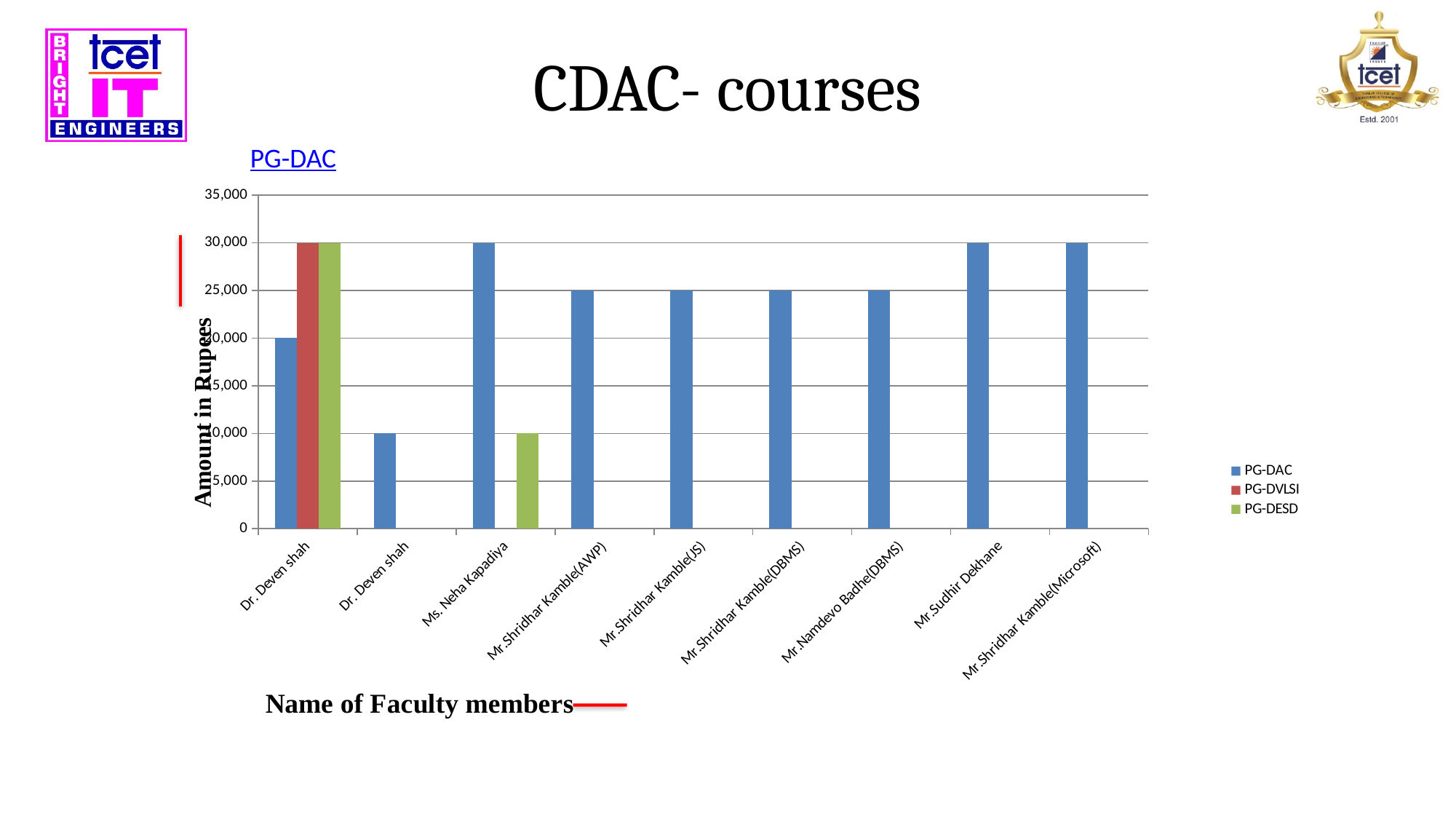
What is the PG-DAC value for Mr.Sudhir Dekhane? 30,000 What is the PG-DVLSI value for the first Dr. Deven shah category? 30,000 How many series does the legend list? 3 What is the PG-DAC value for Mr.Shridhar Kamble(AWP)? 25,000 What is the PG-DESD value for Ms. Neha Kapadiya? 10,000 What is the difference between the PG-DAC values for Mr.Sudhir Dekhane and Mr.Namdevo Badhe(DBMS)? 5,000 Is the PG-DAC value for Mr.Shridhar Kamble(Microsoft) greater or less than 25,000? greater What kind of chart is shown on the slide? bar chart How many faculty-member categories are shown on the x axis? 9 Which is larger, the PG-DAC value for Ms. Neha Kapadiya or the PG-DAC value for Mr.Shridhar Kamble(JS)? Ms. Neha Kapadiya What is the label of the y axis? Amount in Rupees What is the PG-DAC value for Ms. Neha Kapadiya? 30,000